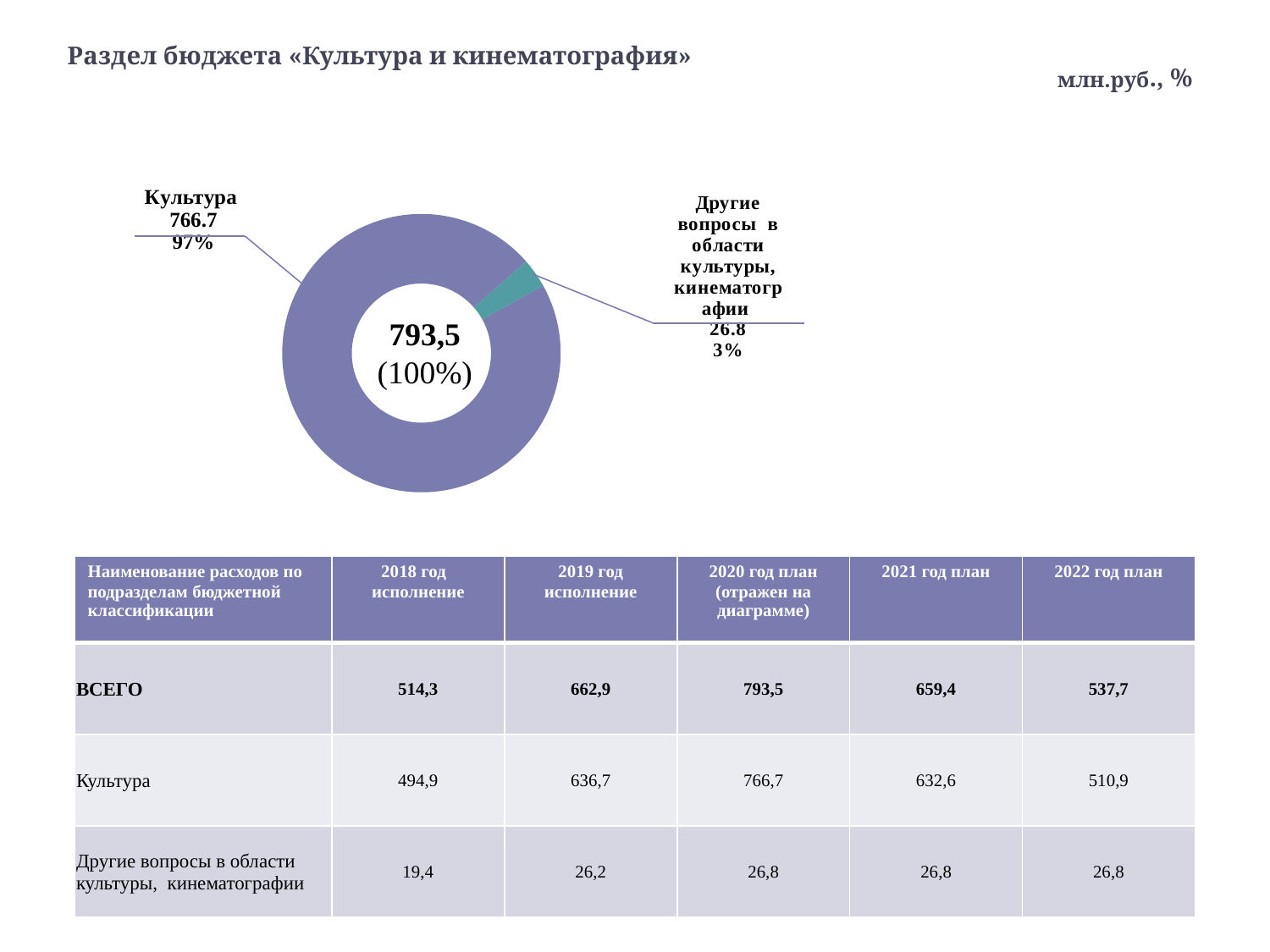
What is the value shown for the slice 'Другие вопросы в области культуры, кинематографии' in the donut chart? 26.8 What is the difference between the Культура value and the 'Другие вопросы в области культуры, кинематографии' value in the donut chart? 739.9 What is the value shown for the Культура slice in the donut chart? 766.7 Which is larger in the donut chart: Культура or Другие вопросы в области культуры, кинематографии? Культура What percentage share does the Культура slice have in the donut chart? 97% What kind of chart is shown on the slide? Donut (pie) chart How many slices does the donut chart have? 2 What percentage share does the slice 'Другие вопросы в области культуры, кинематографии' have in the donut chart? 3% What units are indicated in the top right corner of the slide for the chart? млн.руб., % Which slice of the donut chart is the largest? Культура Which slice of the donut chart is the smallest? Другие вопросы в области культуры, кинематографии What total value is shown in the centre of the donut chart? 793,5 (100%)